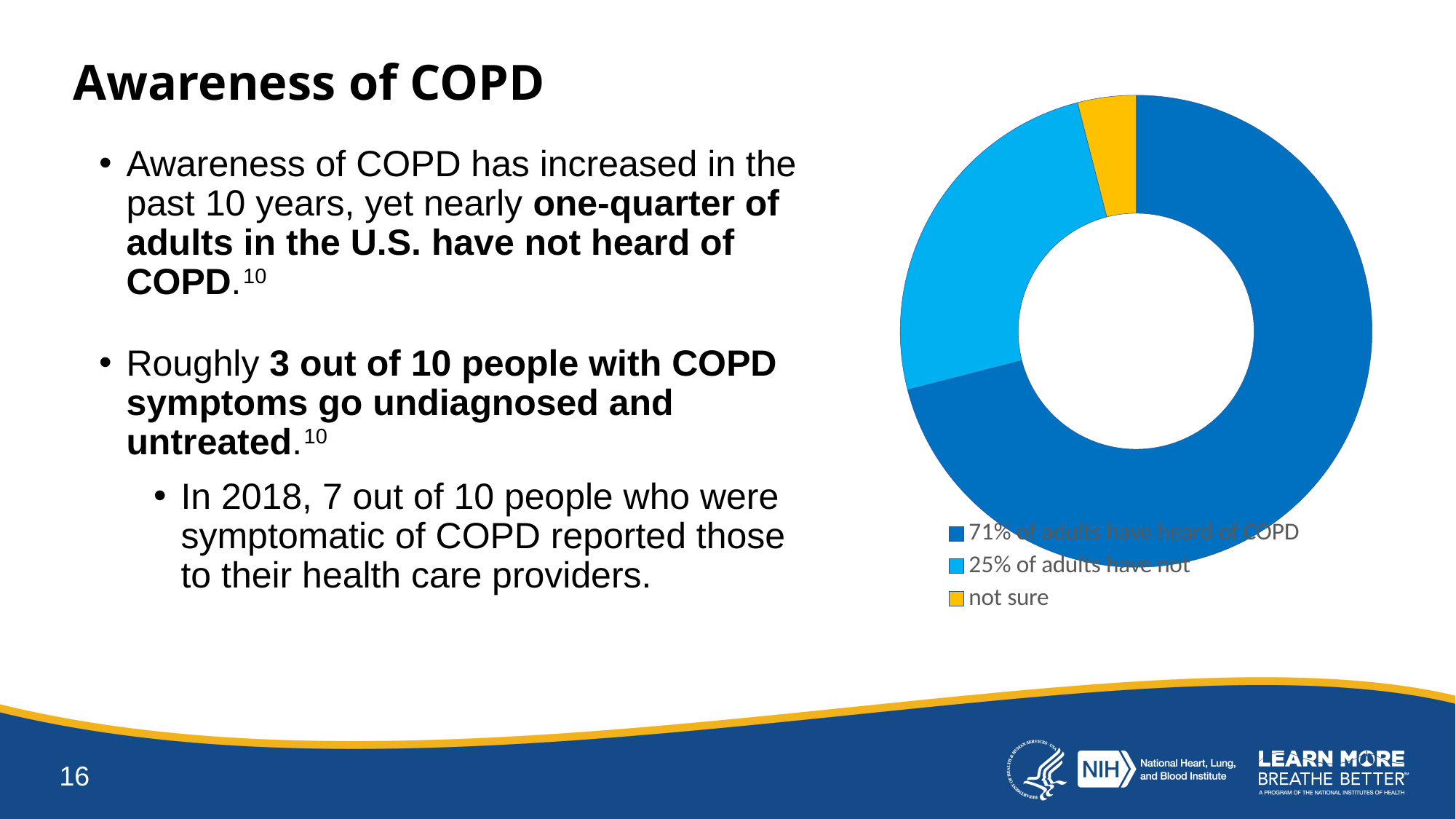
According to the chart legend, what percentage of adults have heard of COPD? 71% What is the difference in percentage points between adults who have heard of COPD and adults who have not? 46 What kind of chart is shown on the slide? doughnut chart What share of the doughnut chart does the 'adults have heard of COPD' slice represent? 71% What colour is the 'not sure' slice in the chart? yellow Which is larger: the share of adults who have heard of COPD or the share who have not? adults who have heard of COPD Which category takes up the largest share of the doughnut chart? 71% of adults have heard of COPD According to the chart legend, what percentage of adults have not heard of COPD? 25% Which category takes up the smallest share of the doughnut chart? not sure What colour represents the '71% of adults have heard of COPD' category in the chart? dark blue How many categories does the chart's legend list? 3